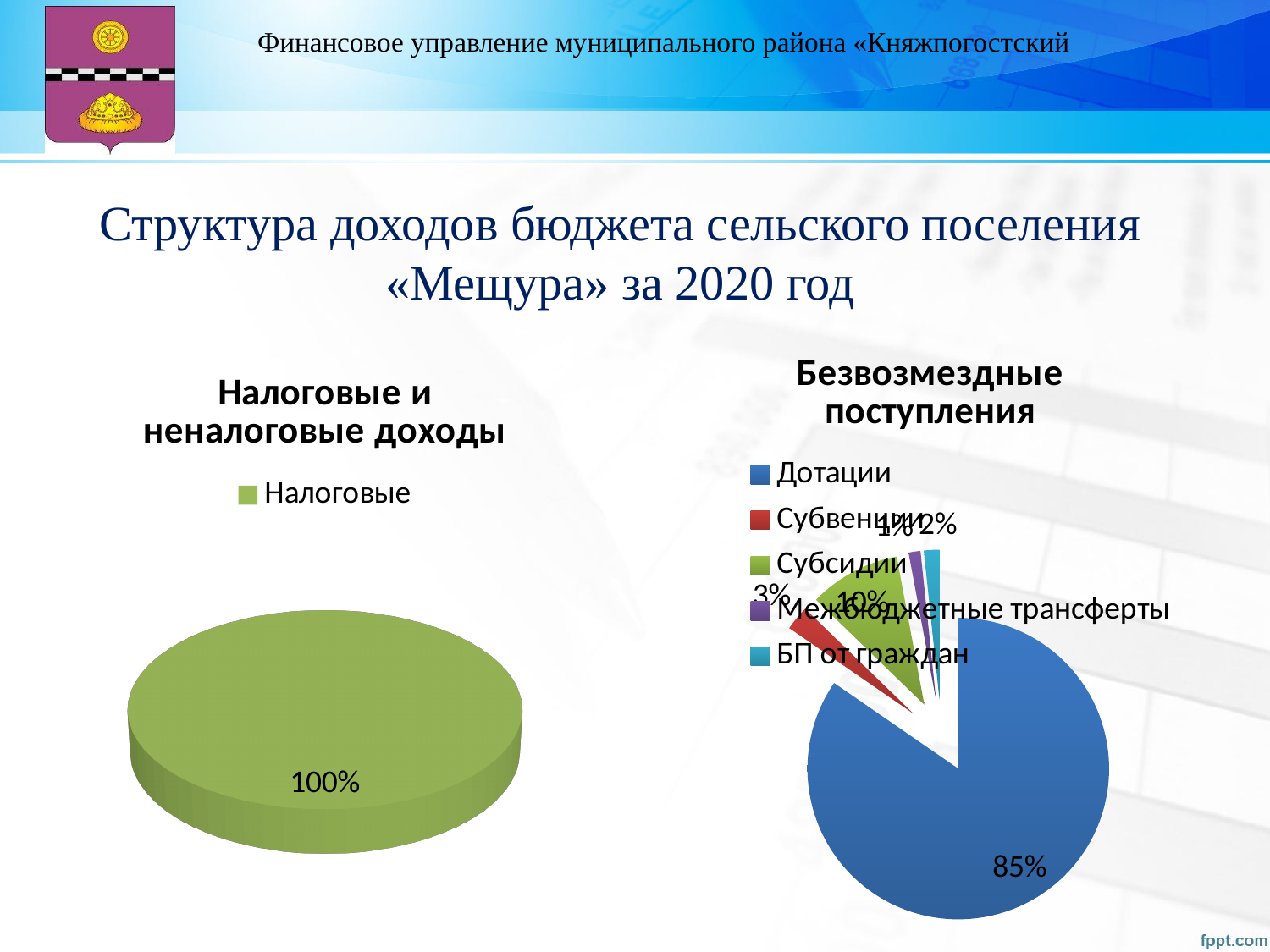
In the "Налоговые и неналоговые доходы" chart, what value is shown for Налоговые? 100% What kind of chart is the "Налоговые и неналоговые доходы" chart? pie chart In the "Безвозмездные поступления" chart, what share is shown for Дотации? 85% In the "Безвозмездные поступления" chart, which is larger, Субсидии or Субвенции? Субсидии How many entries does the legend of the "Налоговые и неналоговые доходы" chart list? 1 In the "Безвозмездные поступления" chart, what share is shown for Субвенции? 3% How many entries does the legend of the "Безвозмездные поступления" chart list? 5 What kind of chart is the "Безвозмездные поступления" chart? pie chart What colour is the Дотации slice in the "Безвозмездные поступления" chart? blue In the "Безвозмездные поступления" chart, what share is shown for Субсидии? 10% In the "Безвозмездные поступления" chart, which category has the largest share? Дотации In the "Безвозмездные поступления" chart, what is the difference between the shares of Дотации and Субсидии? 75%